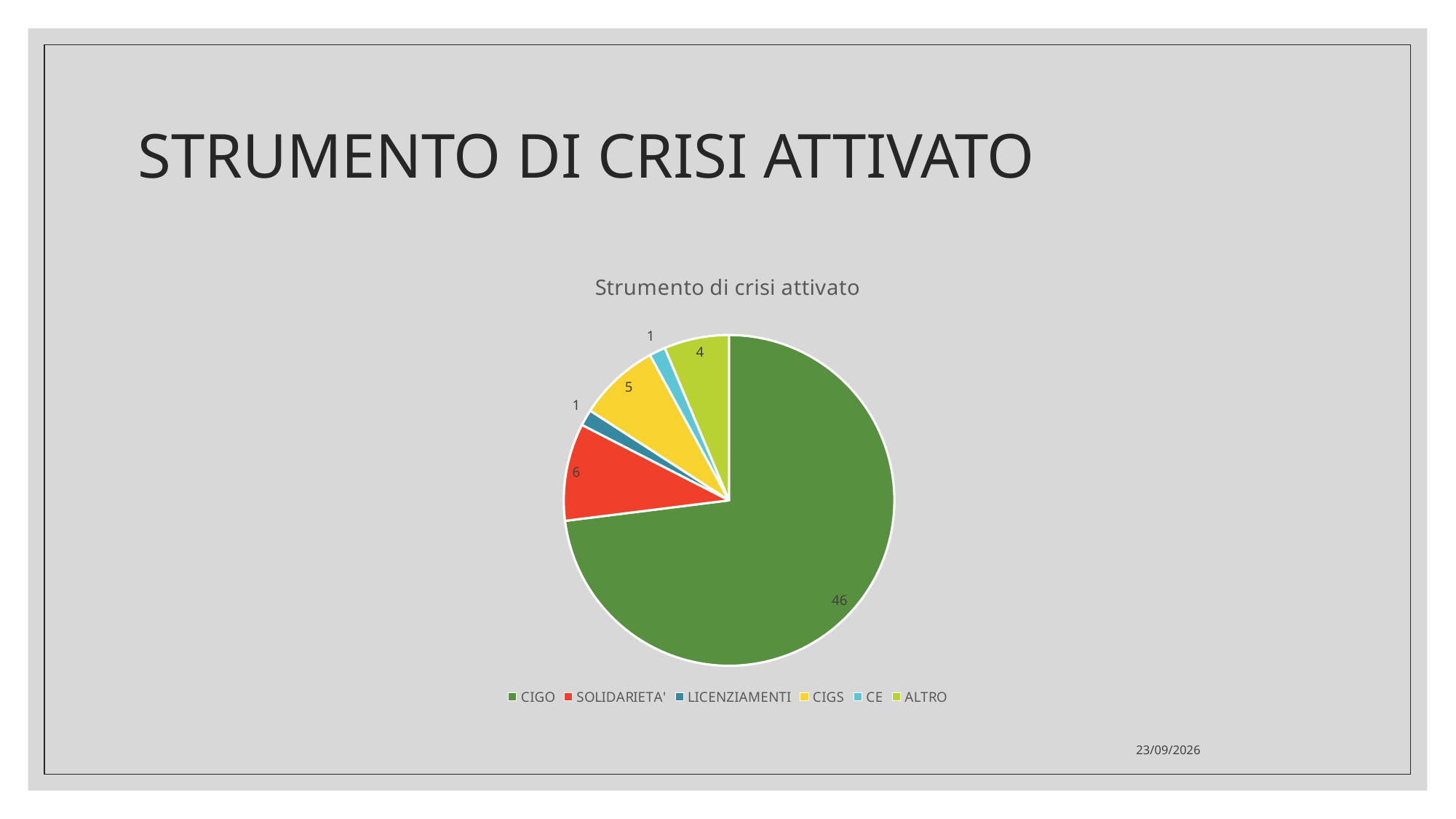
Which category has the largest slice in the pie chart? CIGO What is the value for CIGS in the pie chart? 5 What is the value for SOLIDARIETA' in the pie chart? 6 What is the value for ALTRO in the pie chart? 4 What type of chart is shown on the slide? pie chart Which is larger, the value for CIGS or the value for ALTRO? CIGS What is the value for LICENZIAMENTI in the pie chart? 1 What is the difference between the values for CIGO and SOLIDARIETA'? 40 How many categories does the pie chart have? 6 What is the value for CIGO in the pie chart? 46 What is the total of all the slices in the pie chart? 63 What is the title of the chart? Strumento di crisi attivato